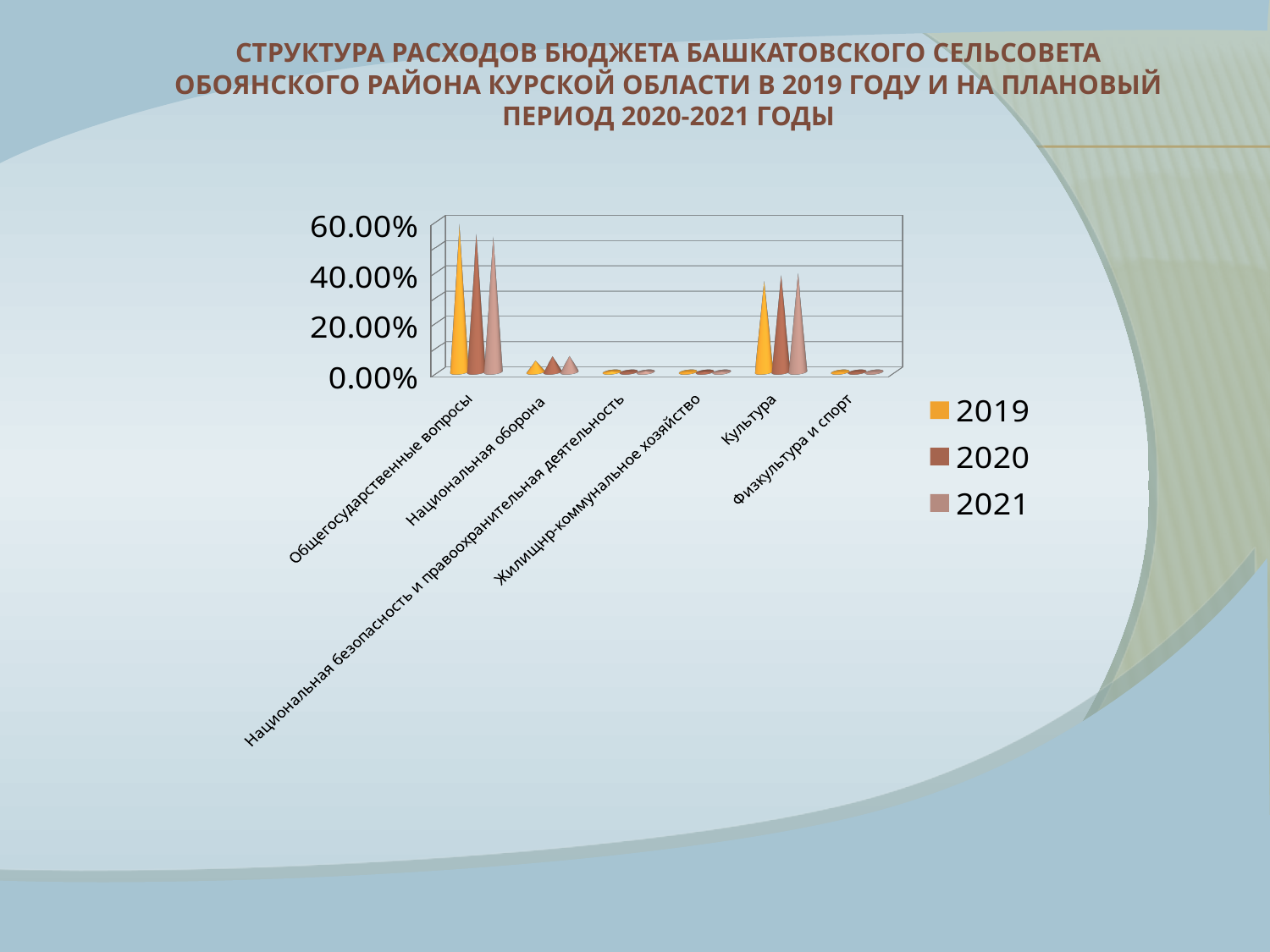
Which is larger in 2019: the value for Общегосударственные вопросы or the value for Культура? Общегосударственные вопросы Is the 2019 value for Общегосударственные вопросы greater or less than 40.00%? greater Which category has the highest share of budget expenditure in the chart? Общегосударственные вопросы What is the highest value shown on the vertical axis of the chart? 60.00% Which is larger in 2021: the value for Культура or the value for Физкультура и спорт? Культура Is the 2021 value for Культура greater or less than 20.00%? greater Which years are listed in the chart legend? 2019, 2020, 2021 How many expenditure categories are shown on the x axis of the chart? 6 What kind of chart is shown on the slide? bar chart Is the 2020 value for Национальная оборона greater or less than 20.00%? less How many series does the chart legend list? 3